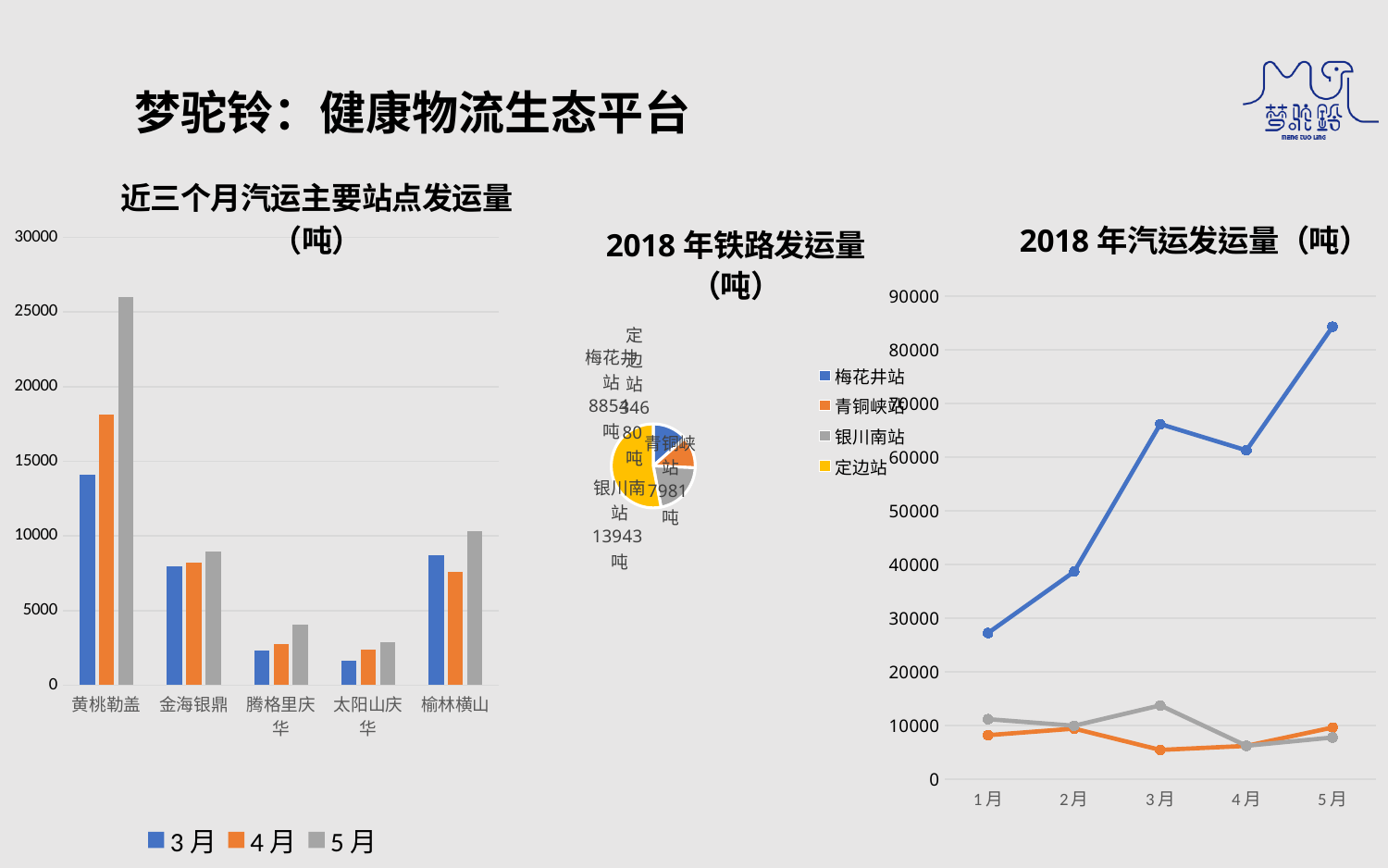
In the chart titled 近三个月汽运主要站点发运量（吨）, which station has the highest 5月 value? 黄桃勒盖 What kind of chart is the chart titled 2018 年铁路发运量（吨）? pie chart In the chart titled 近三个月汽运主要站点发运量（吨）, which station has the lowest 3月 value? 太阳山庆华 What kind of chart is the chart titled 近三个月汽运主要站点发运量（吨）? bar chart In the chart titled 近三个月汽运主要站点发运量（吨）, how many station categories are shown on the x axis? 5 In the chart titled 近三个月汽运主要站点发运量（吨）, how many series does the legend list? 3 In the chart titled 2018 年汽运发运量（吨）, is the 5月 value of the blue line greater or less than 80000? greater In the chart titled 2018 年铁路发运量（吨）, what is the value for 银川南站? 13943 吨 What kind of chart is the chart titled 2018 年汽运发运量（吨）? line chart In the chart titled 2018 年汽运发运量（吨）, how many months are shown on the x axis? 5 In the chart titled 近三个月汽运主要站点发运量（吨）, which is larger: the 4月 value for 黄桃勒盖 or the 4月 value for 金海银鼎? 黄桃勒盖 In the chart titled 近三个月汽运主要站点发运量（吨）, is the 5月 value for 黄桃勒盖 greater or less than 20000? greater